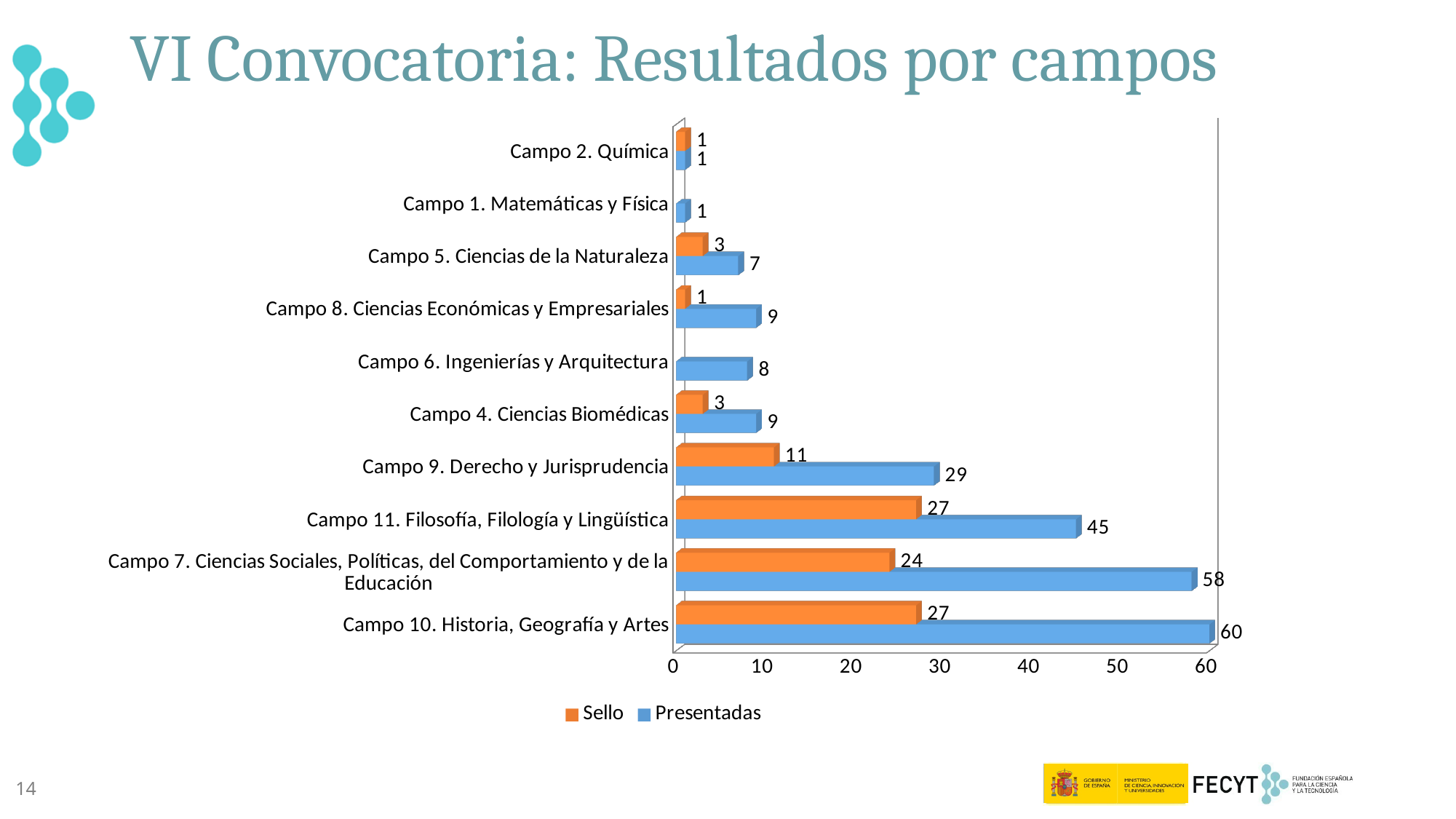
What is the Sello value for Campo 7. Ciencias Sociales, Políticas, del Comportamiento y de la Educación? 24 Which series is shown in orange? Sello Which category has the lowest Presentadas value? Campo 1. Matemáticas y Física and Campo 2. Química (both 1) How many categories are shown on the chart? 10 What kind of chart is shown on the slide? Bar chart What is the Presentadas value for Campo 10. Historia, Geografía y Artes? 60 What is the difference between the Presentadas and Sello values for Campo 11. Filosofía, Filología y Lingüística? 18 Is the Presentadas value for Campo 9. Derecho y Jurisprudencia greater or less than 20? greater Which category has the highest Presentadas value? Campo 10. Historia, Geografía y Artes What is the Presentadas value for Campo 9. Derecho y Jurisprudencia? 29 How many series does the legend list? 2 Which is larger: the Presentadas value for Campo 7. Ciencias Sociales, Políticas, del Comportamiento y de la Educación or for Campo 11. Filosofía, Filología y Lingüística? Campo 7. Ciencias Sociales, Políticas, del Comportamiento y de la Educación